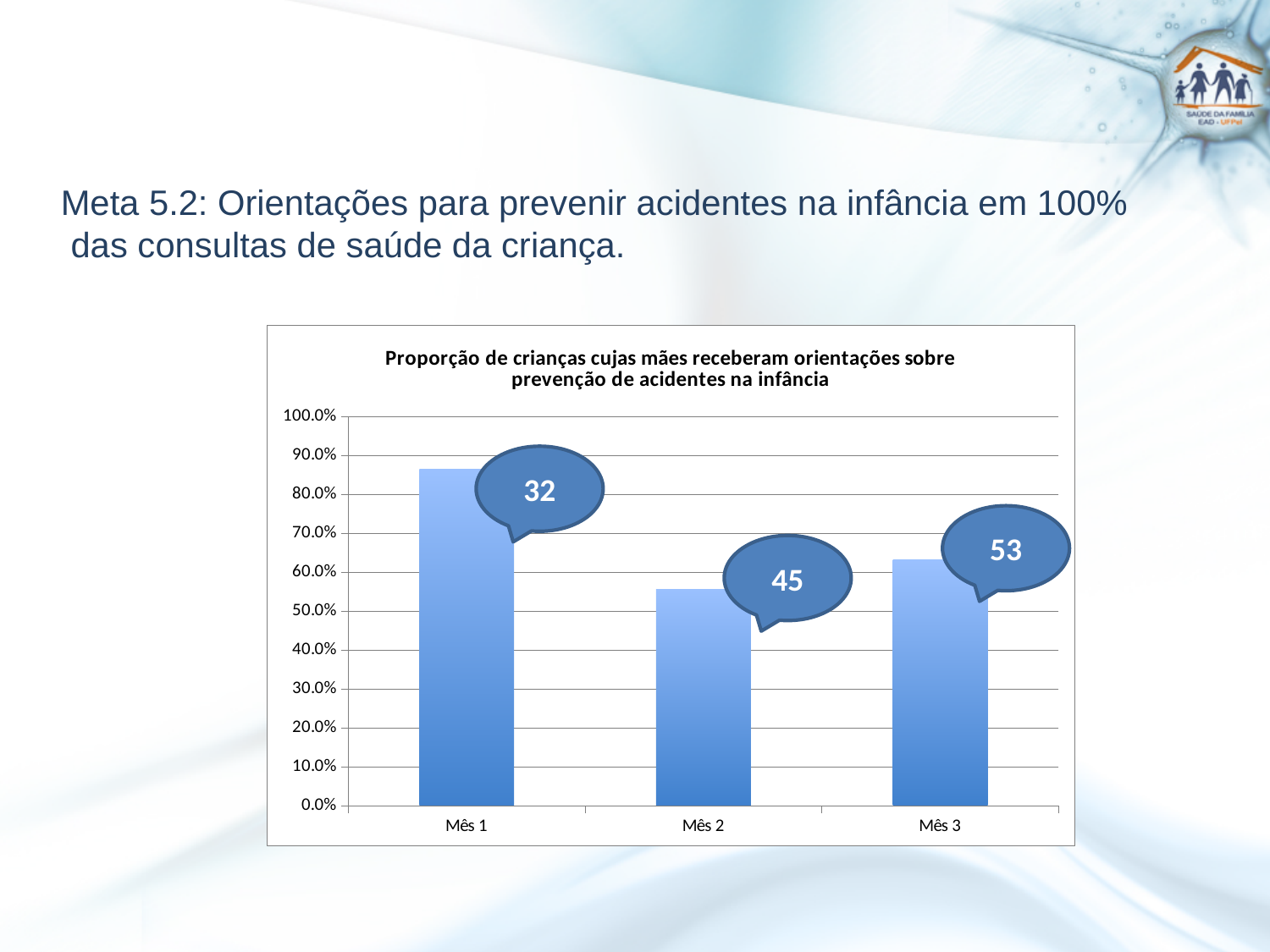
Is the value for Mês 3 greater or less than 60.0%? greater Is the value for Mês 1 greater or less than 90.0%? less Which is larger, the value for Mês 2 or the value for Mês 3? Mês 3 How many categories (months) are plotted on the x axis? 3 What number is shown in the callout next to the Mês 3 bar? 53 What kind of chart is shown on the slide? bar chart What is the title of the chart? Proporção de crianças cujas mães receberam orientações sobre prevenção de acidentes na infância Is the value for Mês 1 greater or less than 80.0%? greater Which month has the highest bar? Mês 1 Do the values rise or fall from Mês 1 to Mês 2? fall Which month has the lowest bar? Mês 2